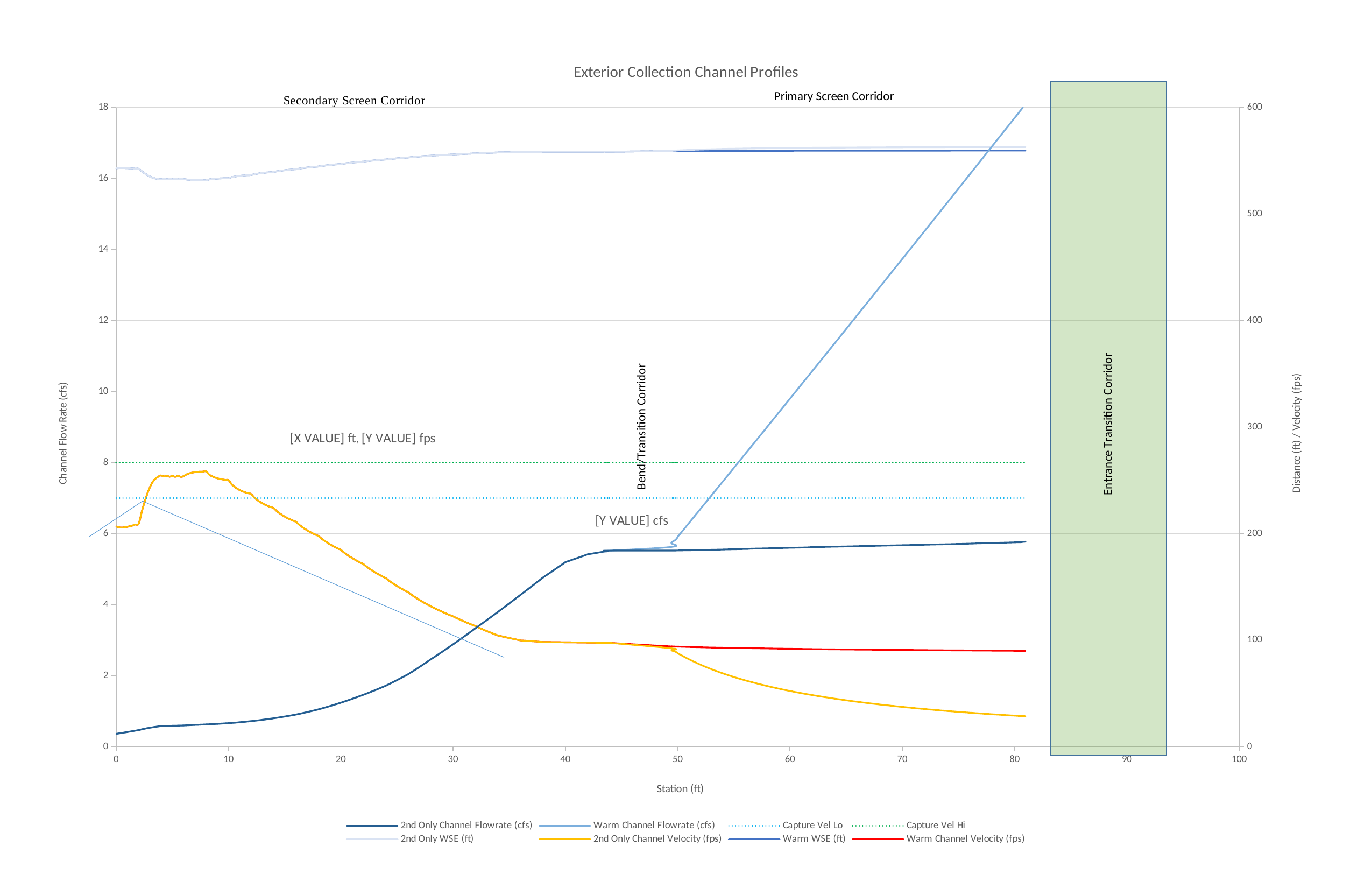
Does the 2nd Only Channel Velocity (fps) line rise or fall between station 10 and station 80? fall What kind of chart is shown on the slide? line chart At station 60, which is larger: the Warm Channel Velocity (fps) or the 2nd Only Channel Velocity (fps)? Warm Channel Velocity (fps) Is the Warm Channel Flowrate (cfs) at station 70 greater or less than 10? greater How many series does the legend list? 8 Does the Warm Channel Flowrate (cfs) line rise or fall between station 50 and station 80? rise Does the 2nd Only Channel Flowrate (cfs) line rise or fall as station increases from 0 to 80? rise Is the Capture Vel Lo line greater or less than 8 on the left axis? less Is the 2nd Only Channel Flowrate (cfs) at station 80 greater or less than 4? greater What is the label of the x axis? Station (ft) What is the title of the chart? Exterior Collection Channel Profiles At station 80, which is larger: the Warm Channel Flowrate (cfs) or the 2nd Only Channel Flowrate (cfs)? Warm Channel Flowrate (cfs)